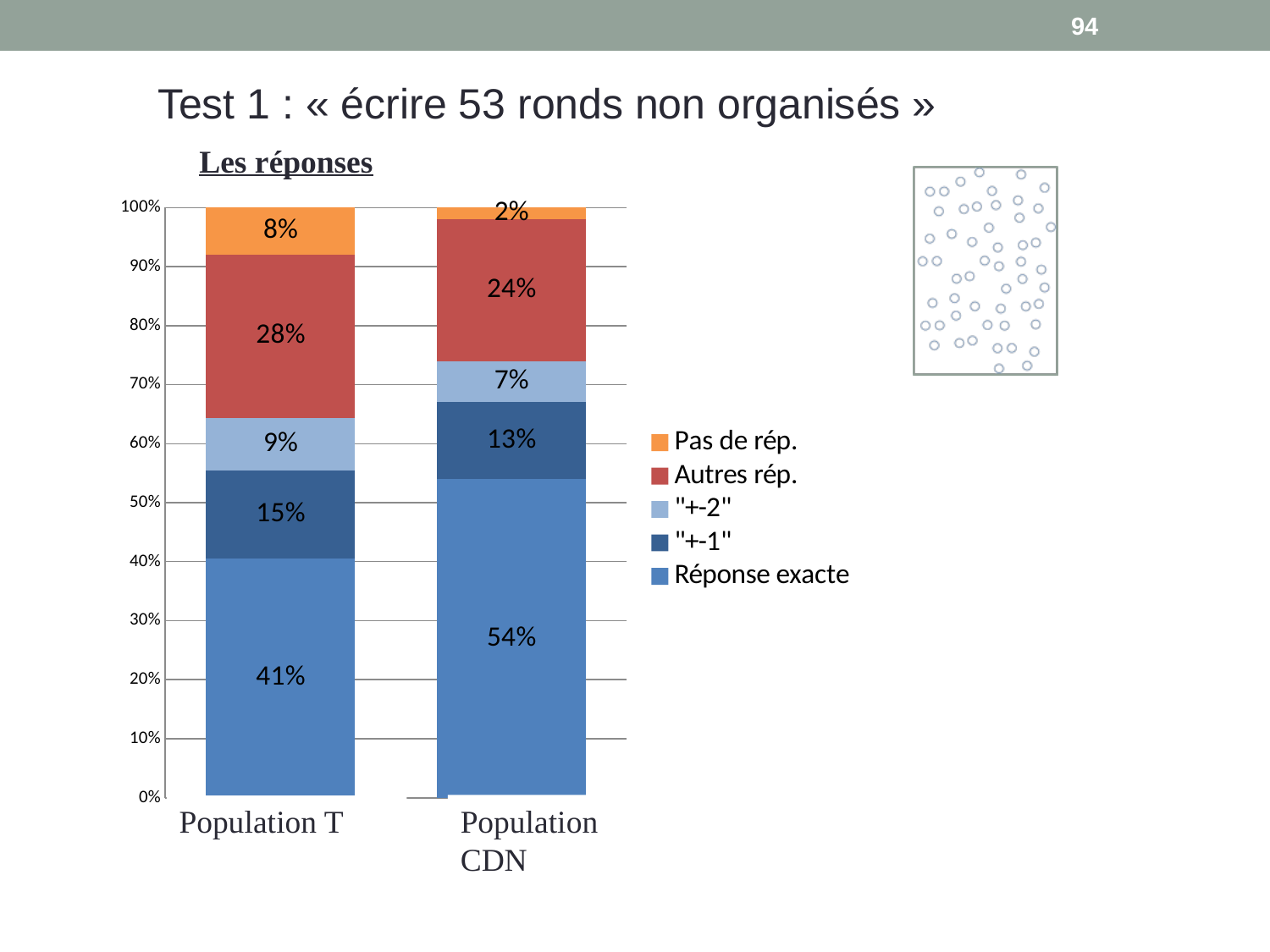
What is the difference between the "Autres rép." values for Population T and Population CDN? 4% What is the value of "Réponse exacte" for Population CDN? 54% What is the value of "Autres rép." for Population CDN? 24% What type of chart is shown on the slide? stacked bar chart What is the title of the chart? Les réponses How many series does the legend list? 5 How many categories are shown on the x axis of the chart? 2 What is the value of "+-1" for Population CDN? 13% What is the value of "Réponse exacte" for Population T? 41% Which series has the lowest value for Population CDN? Pas de rép. Which population has the higher value for "Réponse exacte"? Population CDN What is the value of "Pas de rép." for Population T? 8%